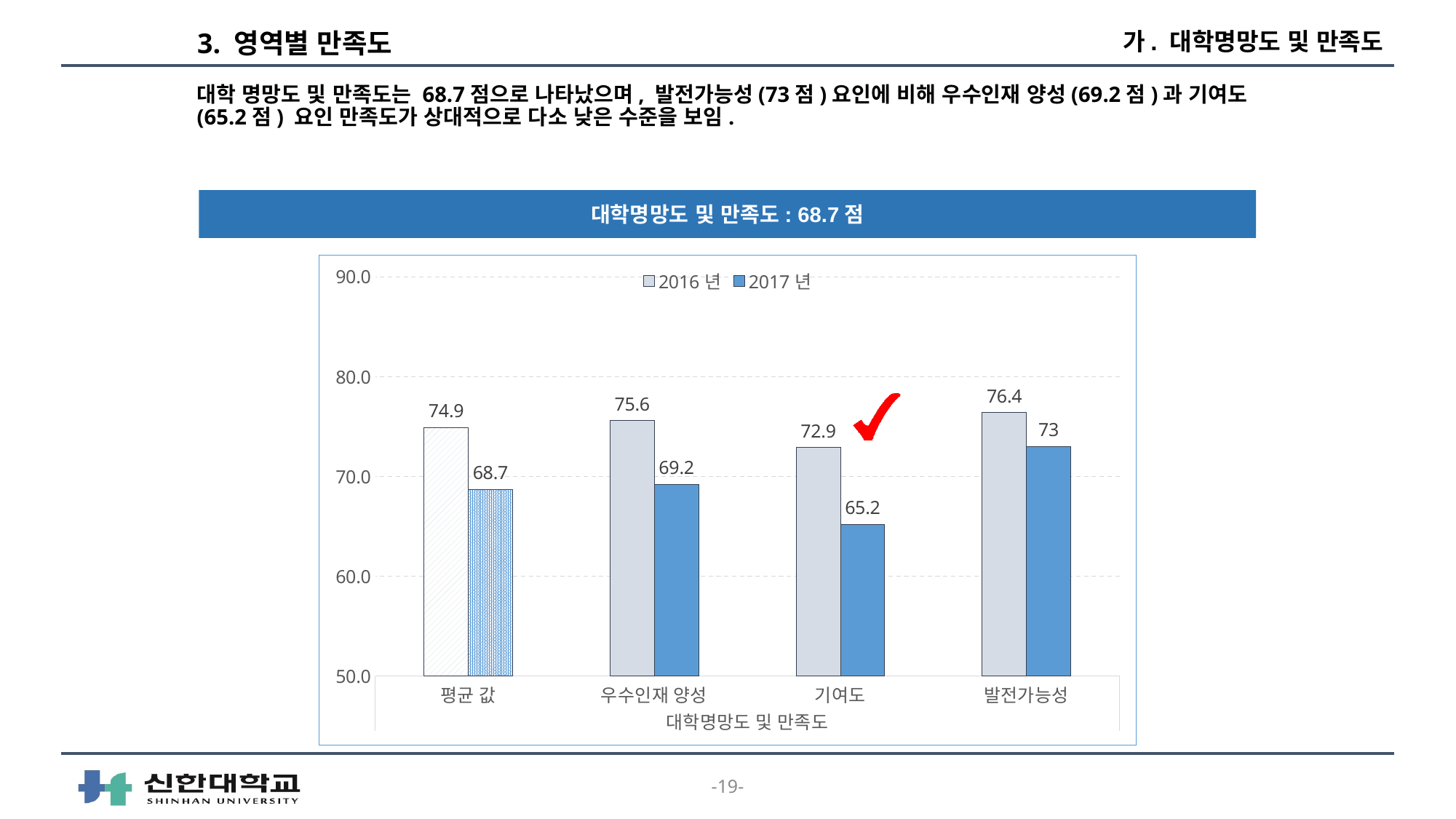
Which category has the highest 2017년 value? 발전가능성 Which category has the lowest 2016년 value? 기여도 What is the difference between the 2016년 and 2017년 values for 기여도? 7.7 What is the 2017년 value for 기여도? 65.2 How many series does the legend list? 2 What is the x-axis title of the chart? 대학명망도 및 만족도 What kind of chart is shown on the slide? Bar chart Which is larger for 우수인재 양성: the 2016년 value or the 2017년 value? 2016년 How many categories are shown on the x axis? 4 What is the 2016년 value for 발전가능성? 76.4 What is the 2017년 value for 평균 값? 68.7 What is the 2016년 value for 우수인재 양성? 75.6